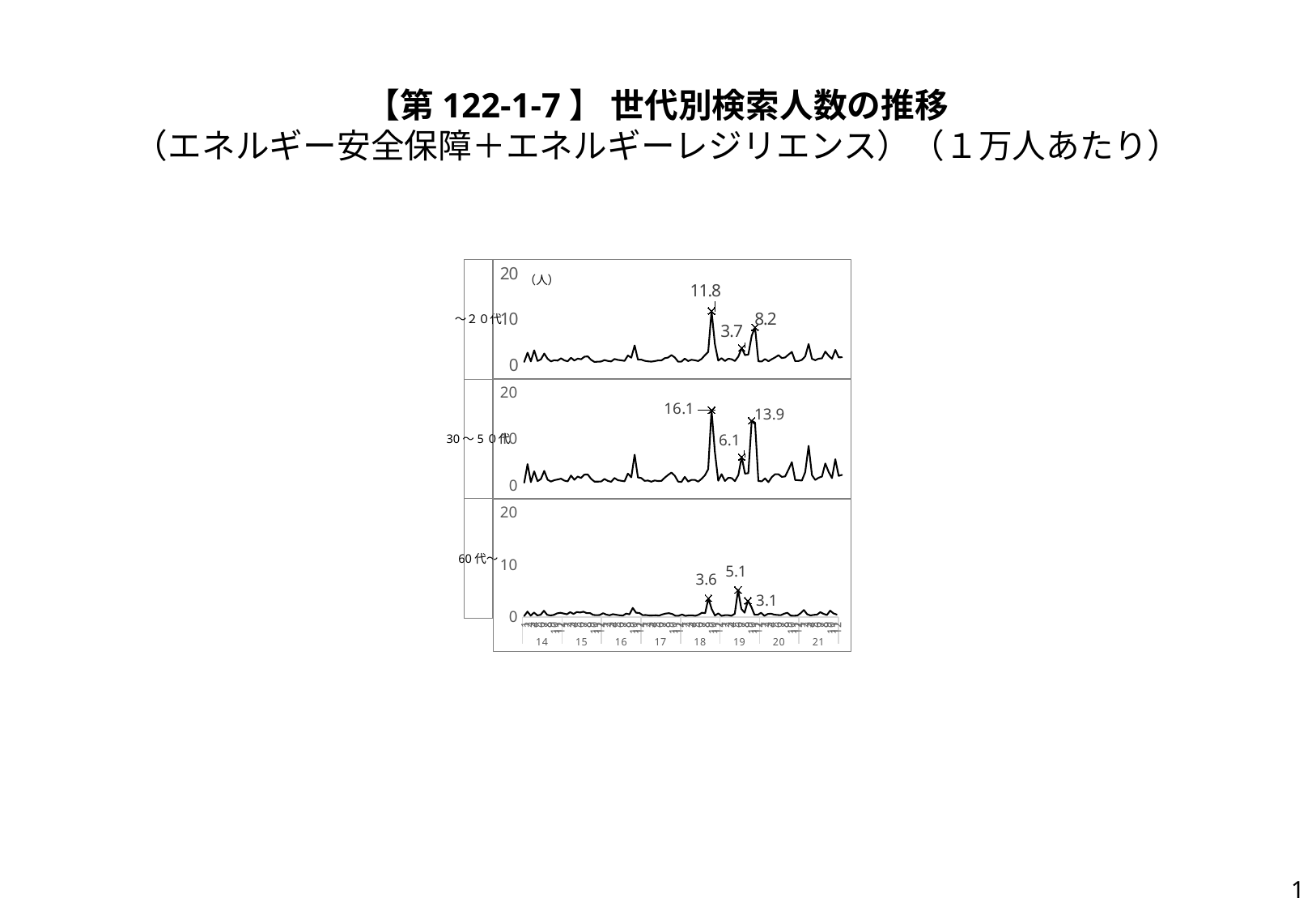
What type of chart is used in each of the three panels on the slide? line chart In the bottom panel (60代～), is the highest labelled peak greater or less than 10? less In the top panel (～20代), what is the difference between the 11.8 peak and the 8.2 peak? 3.6 In the middle panel (30～50代), what is the difference between the 16.1 peak and the 13.9 peak? 2.2 How many age-group panels are shown in the chart? 3 In the bottom panel (60代～), what is the highest labelled peak value? 5.1 In the top panel (～20代), what is the value of the labelled peak that follows the 3.7 point? 8.2 In the middle panel (30～50代), what is the value of the labelled point between the 16.1 and 13.9 peaks? 6.1 In the top panel (～20代), what is the highest labelled peak value? 11.8 Which age group has the higher maximum labelled peak, ～20代 or 30～50代? 30～50代 In the middle panel (30～50代), what is the highest labelled peak value? 16.1 In the bottom panel (60代～), what is the value of the last labelled point? 3.1